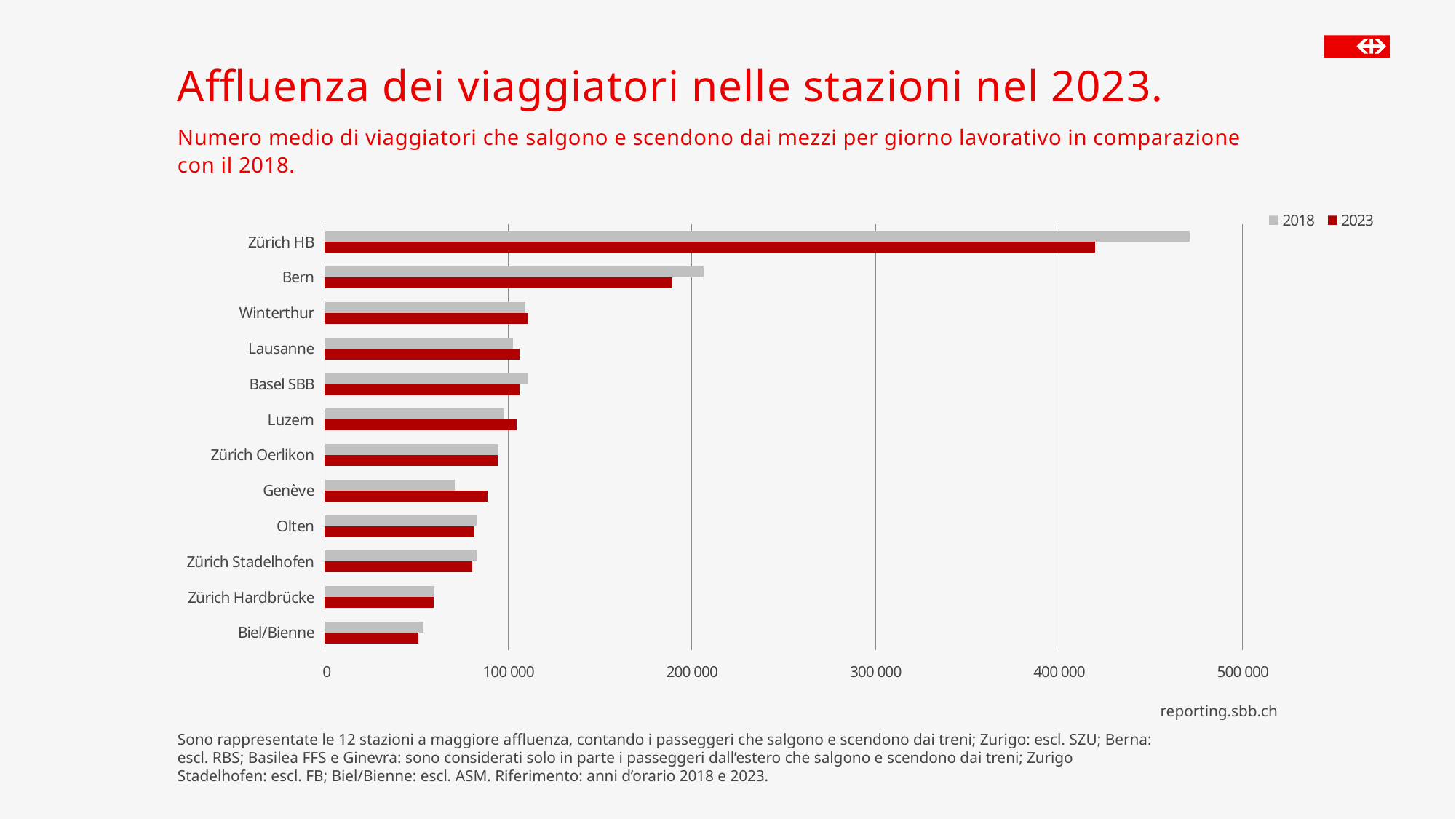
For Zürich HB, which year has the larger value, 2018 or 2023? 2018 How many stations are shown in the chart? 12 Is the 2023 value for Bern greater or less than 200 000? less Which station has the lowest value for 2023? Biel/Bienne What kind of chart is shown on the slide? bar chart For Genève, which year has the larger value, 2018 or 2023? 2023 Is the 2023 value for Biel/Bienne greater or less than 100 000? less How many series does the legend list? 2 Is the 2023 value for Zürich HB greater or less than 400 000? greater Which colour represents the 2023 series in the chart? red Which station has the highest value for 2023? Zürich HB